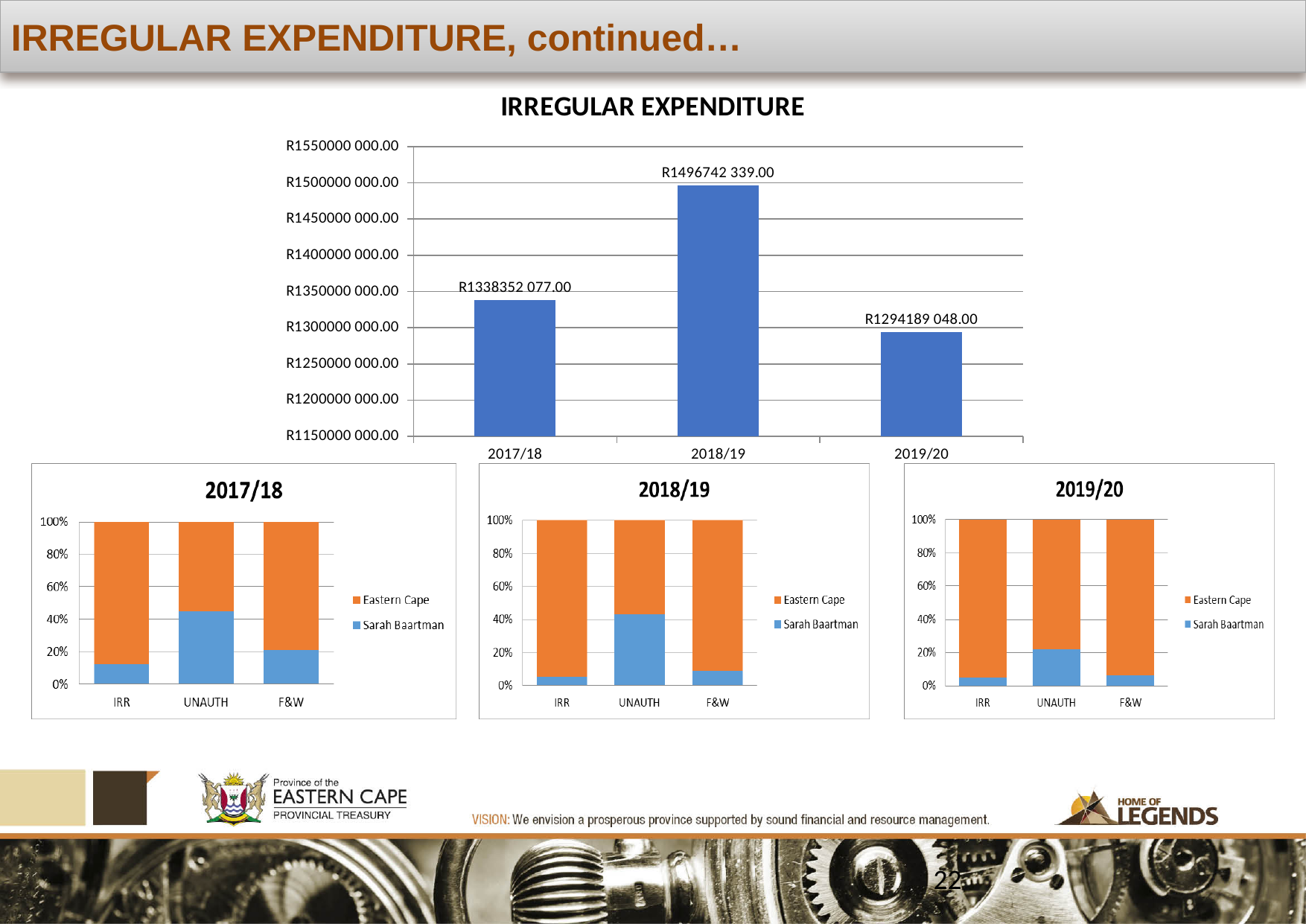
In the IRREGULAR EXPENDITURE bar chart at the top, how many years are shown? 3 What kind of chart is the 2017/18 chart at the bottom left? stacked bar chart In the IRREGULAR EXPENDITURE bar chart at the top, what is the value for 2017/18? R1338352 077.00 In the 2018/19 chart at the bottom centre, how many series does the legend list? 2 In the IRREGULAR EXPENDITURE bar chart at the top, does the value rise or fall from 2018/19 to 2019/20? fall In the IRREGULAR EXPENDITURE bar chart at the top, which year has the highest value? 2018/19 In the IRREGULAR EXPENDITURE bar chart at the top, which year has the lowest value? 2019/20 In the IRREGULAR EXPENDITURE bar chart at the top, what is the value for 2019/20? R1294189 048.00 In the 2019/20 chart at the bottom right, is the Sarah Baartman share for UNAUTH greater or less than 40%? less In the 2018/19 chart at the bottom centre, which category has the larger Sarah Baartman share, IRR or UNAUTH? UNAUTH In the IRREGULAR EXPENDITURE bar chart at the top, what is the value for 2018/19? R1496742 339.00 In the 2017/18 chart at the bottom left, is the Sarah Baartman share for UNAUTH greater or less than 40%? greater